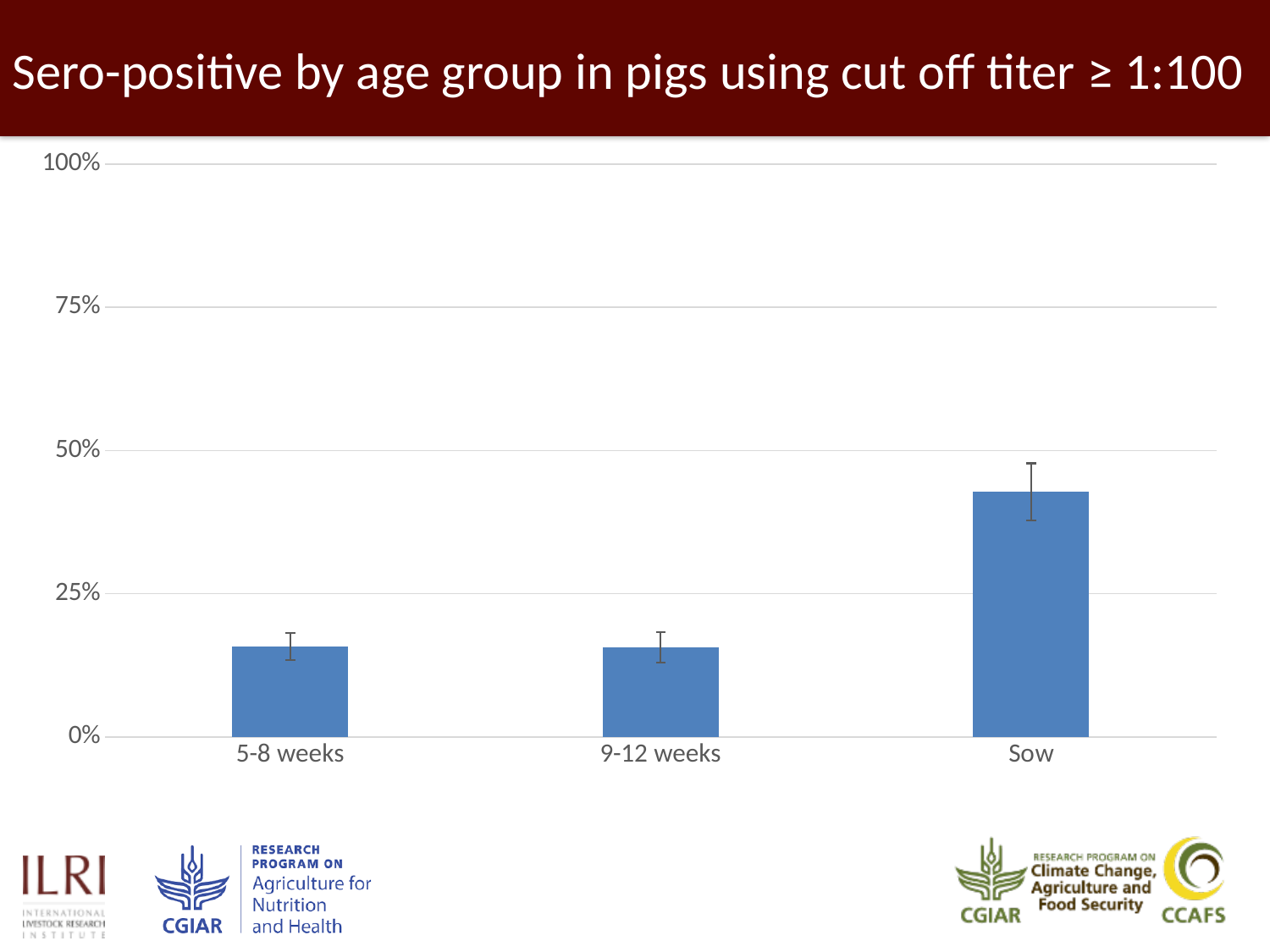
Which age group has the highest sero-positive percentage? Sow Is the value for Sow greater or less than 25%? greater Is the value for 5-8 weeks greater or less than 25%? less How many age groups are shown on the x axis? 3 What is the title of the chart? Sero-positive by age group in pigs using cut off titer ≥ 1:100 What kind of chart is shown on the slide? bar chart Which is larger, the value for Sow or the value for 5-8 weeks? Sow Is the value for 9-12 weeks greater or less than 25%? less What is the highest value shown on the y axis? 100% Which is larger, the value for 9-12 weeks or the value for Sow? Sow